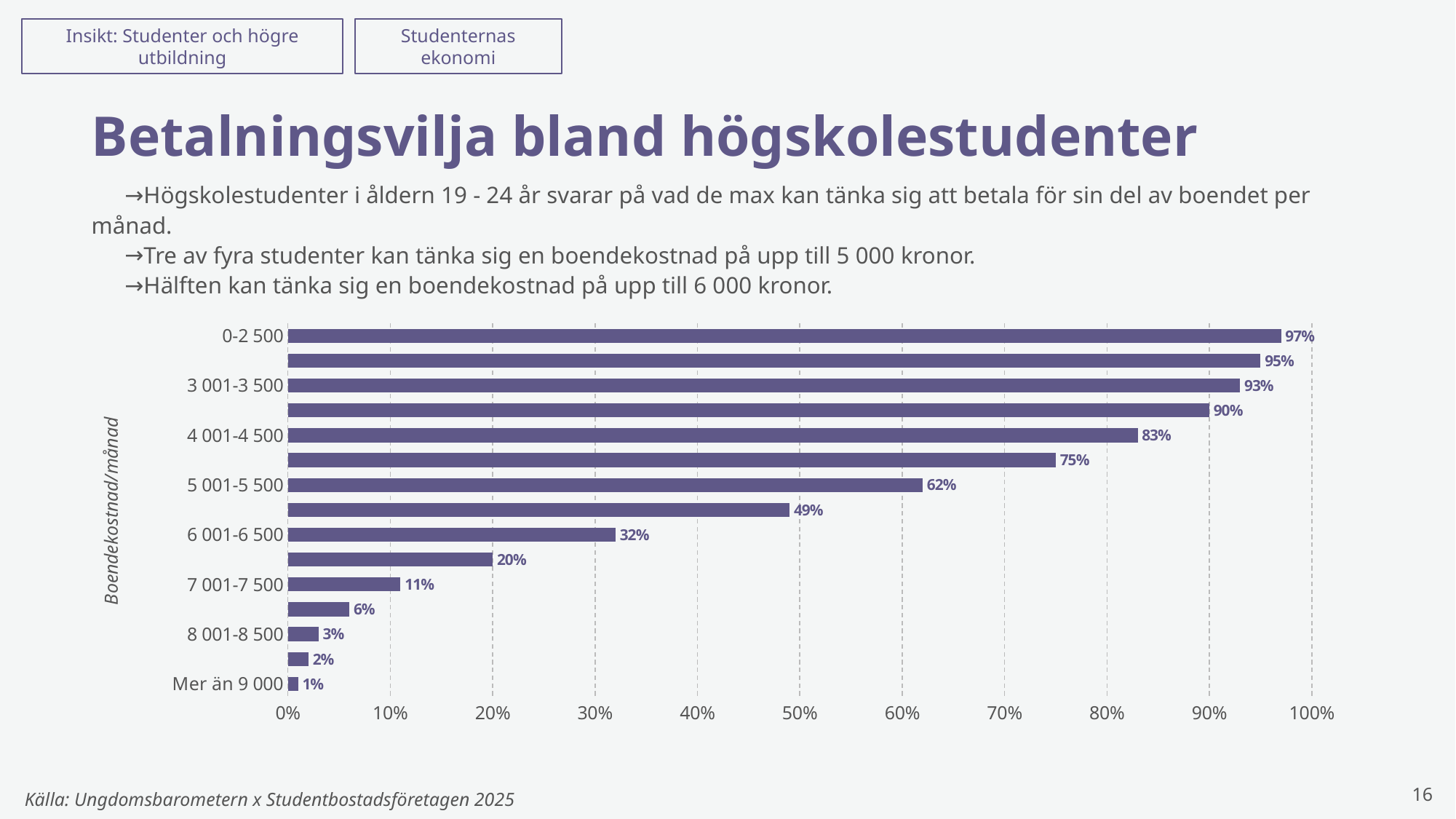
What kind of chart is shown on the slide? Bar chart How many bars are plotted in the chart? 15 What is the value for the Mer än 9 000 category? 1% What is the value for the 6 001-6 500 category? 32% What is the value for the 4 001-4 500 category? 83% Is the value for 5 001-5 500 greater or less than 50%? greater Which labelled category has the lowest value? Mer än 9 000 What is the difference between the values for 5 001-5 500 and 6 001-6 500? 30% What is the value for the 0-2 500 category? 97% Which is larger, the value for 3 001-3 500 or the value for 7 001-7 500? 3 001-3 500 Which labelled category has the highest value? 0-2 500 What is the title of the vertical axis of the chart? Boendekostnad/månad